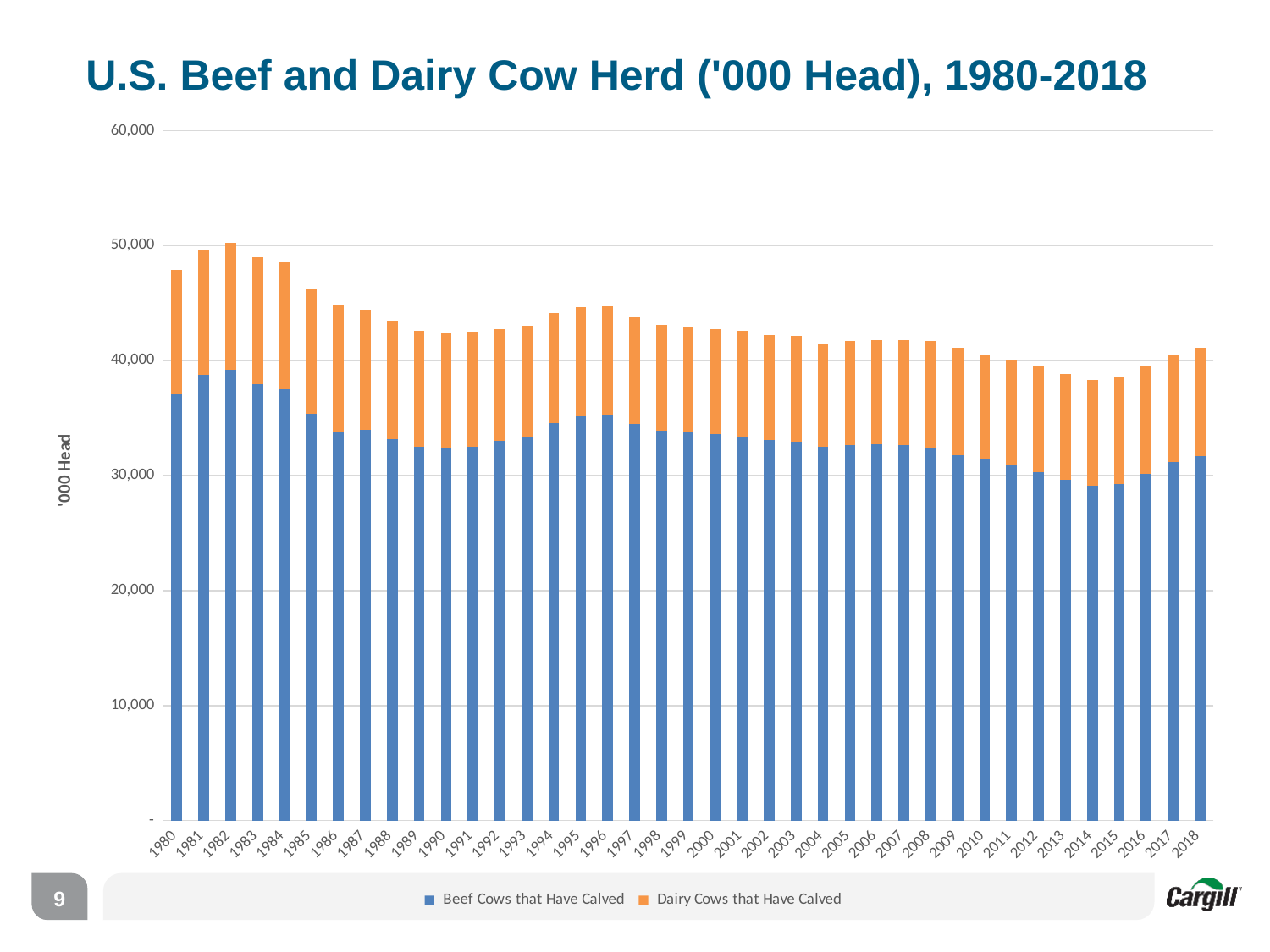
Is the value for Beef Cows that Have Calved in 2014 greater or less than 30,000? less Is the total cow herd for 2014 greater or less than 40,000? less What is the label on the y axis? '000 Head Which year has the highest total cow herd? 1982 How many series does the legend list? 2 Which is larger, the total cow herd in 1982 or in 2014? 1982 How many years are plotted along the x axis? 39 Is the total cow herd for 1980 greater or less than 45,000? greater What kind of chart is shown on the slide? Stacked bar chart Does the total cow herd generally rise or fall from 1980 to 2018? Fall Which is larger, the Beef Cows that Have Calved value in 1980 or in 2018? 1980